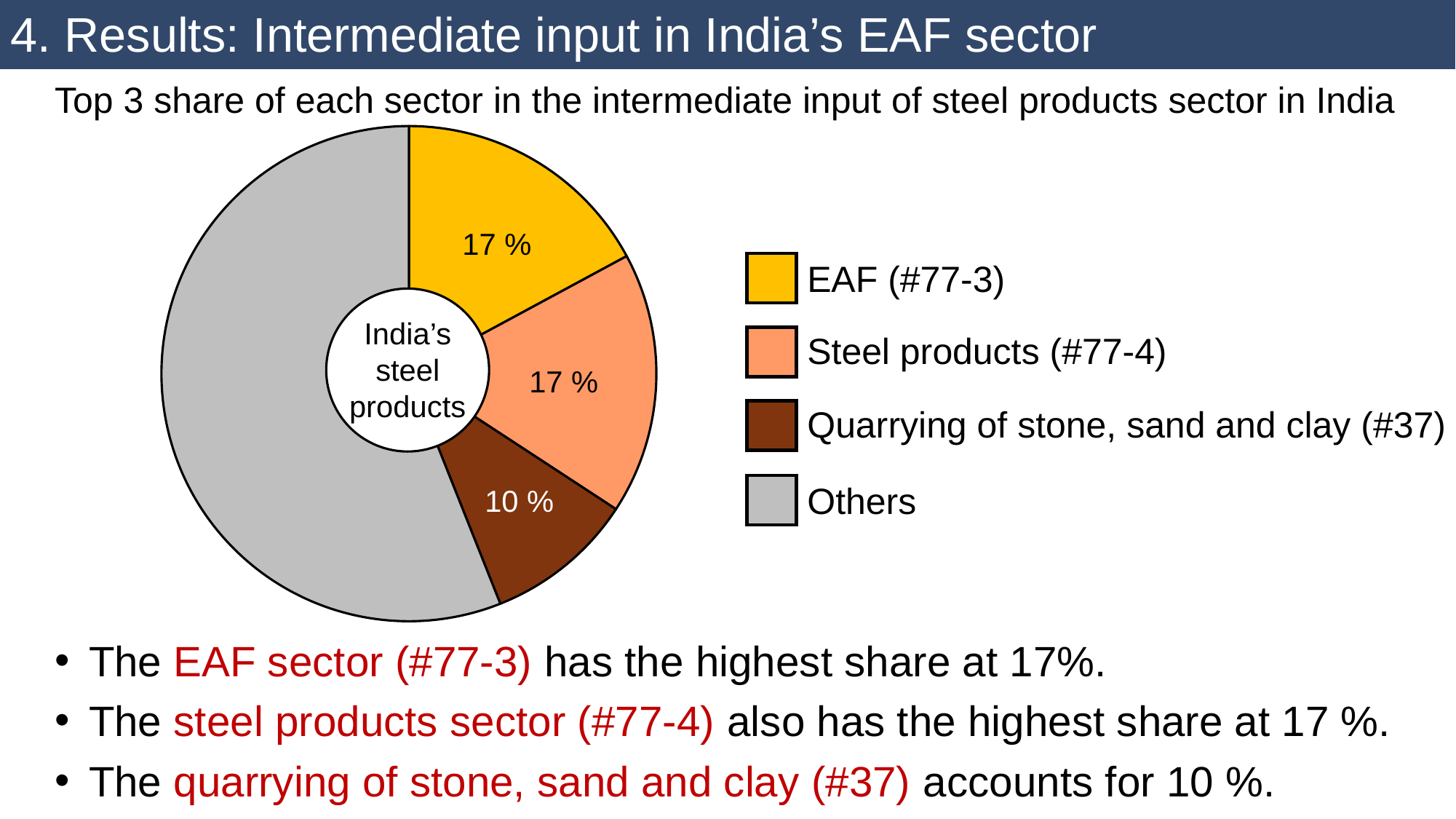
What colour is the EAF (#77-3) slice in the pie chart? Yellow Which slice of the pie chart is the largest? Others How many entries does the legend list? 4 What is the difference between the share of Steel products (#77-4) and the share of Quarrying of stone, sand and clay (#37)? 7 % Which has a larger share, EAF (#77-3) or Quarrying of stone, sand and clay (#37)? EAF (#77-3) What kind of chart is shown on the slide? Pie chart Which of the labelled sectors has the smallest share in the pie chart? Quarrying of stone, sand and clay (#37) What share does Quarrying of stone, sand and clay (#37) have in the pie chart? 10 % What share does EAF (#77-3) have in the pie chart? 17 % How many slices does the pie chart have? 4 What share does Steel products (#77-4) have in the pie chart? 17 % What text is written in the centre of the pie chart? India's steel products